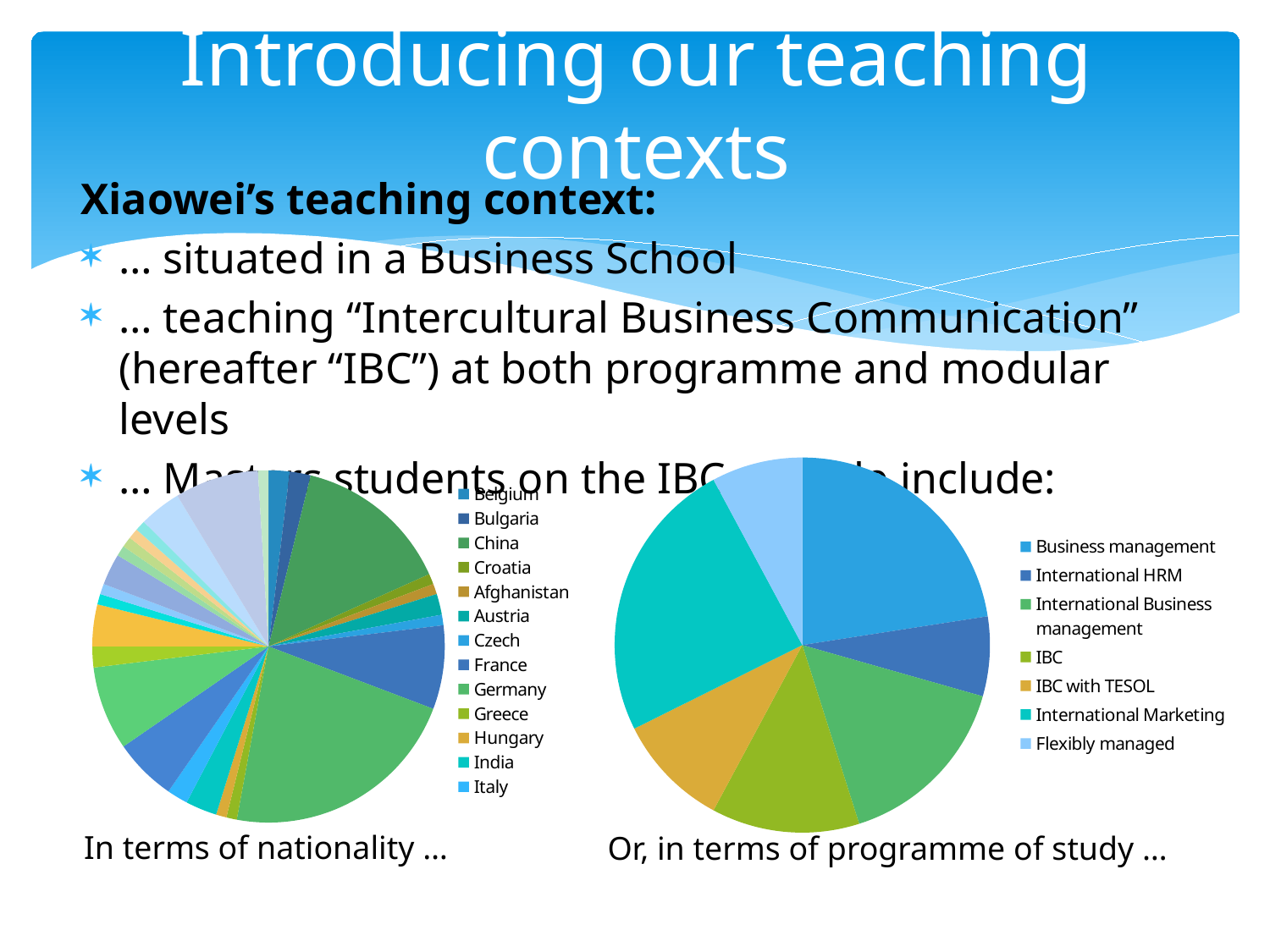
In the chart on the right (programme of study), which slice is larger: Business management or International HRM? Business management In the chart on the left (nationality), how many entries are readable in the legend? 13 In the chart on the right (programme of study), which slice is larger: International Business management or Flexibly managed? International Business management In the chart on the right (programme of study), which slice is larger: International Marketing or IBC with TESOL? International Marketing What kind of chart is the chart on the left, labelled "In terms of nationality ..."? pie chart In the chart on the left (nationality), what is the first entry listed in the legend? Belgium What kind of chart is the chart on the right, labelled "Or, in terms of programme of study ..."? pie chart In the chart on the right (programme of study), how many entries does the legend list? 7 In the chart on the right (programme of study), what is the first entry listed in the legend? Business management